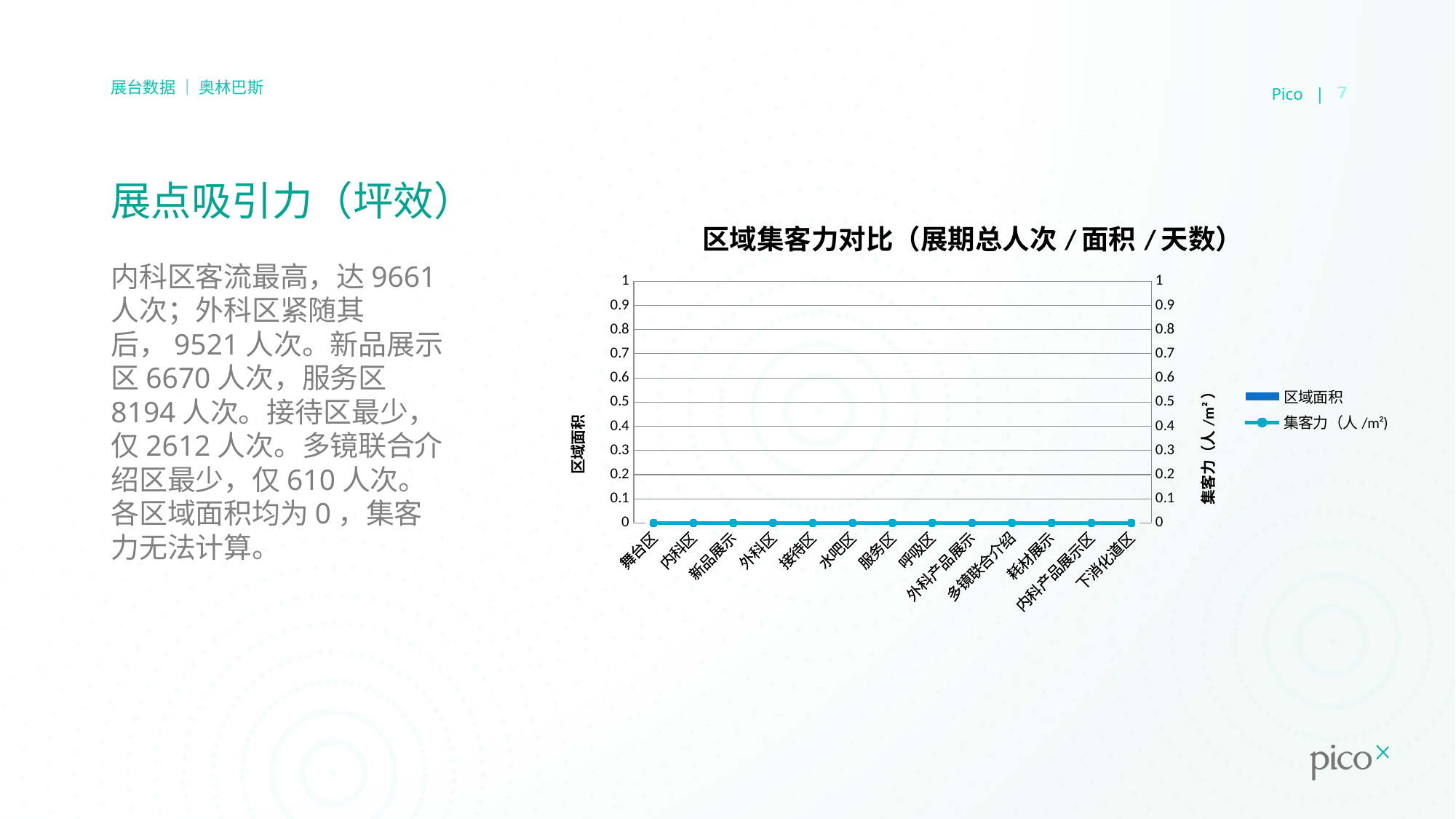
Is the 区域面积 value for 接待区 greater or less than 0.1? less What is the 集客力（人/m²） value for 多镜联合介绍? 0 Is the 集客力（人/m²） value for 服务区 greater or less than 0.5? less What kind of chart is shown on the slide? bar and line chart How many series does the chart legend list? 2 What is the 集客力（人/m²） value for 下消化道区? 0 Do the 集客力（人/m²） values rise, fall, or stay flat across the categories on the x axis? stay flat What are the two entries listed in the chart legend? 区域面积 and 集客力（人/m²） What is the 区域面积 value for 舞台区? 0 How many categories are shown on the x axis of the chart? 13 What is the 集客力（人/m²） value for 内科区? 0 What is the title of the chart? 区域集客力对比（展期总人次 / 面积 / 天数）